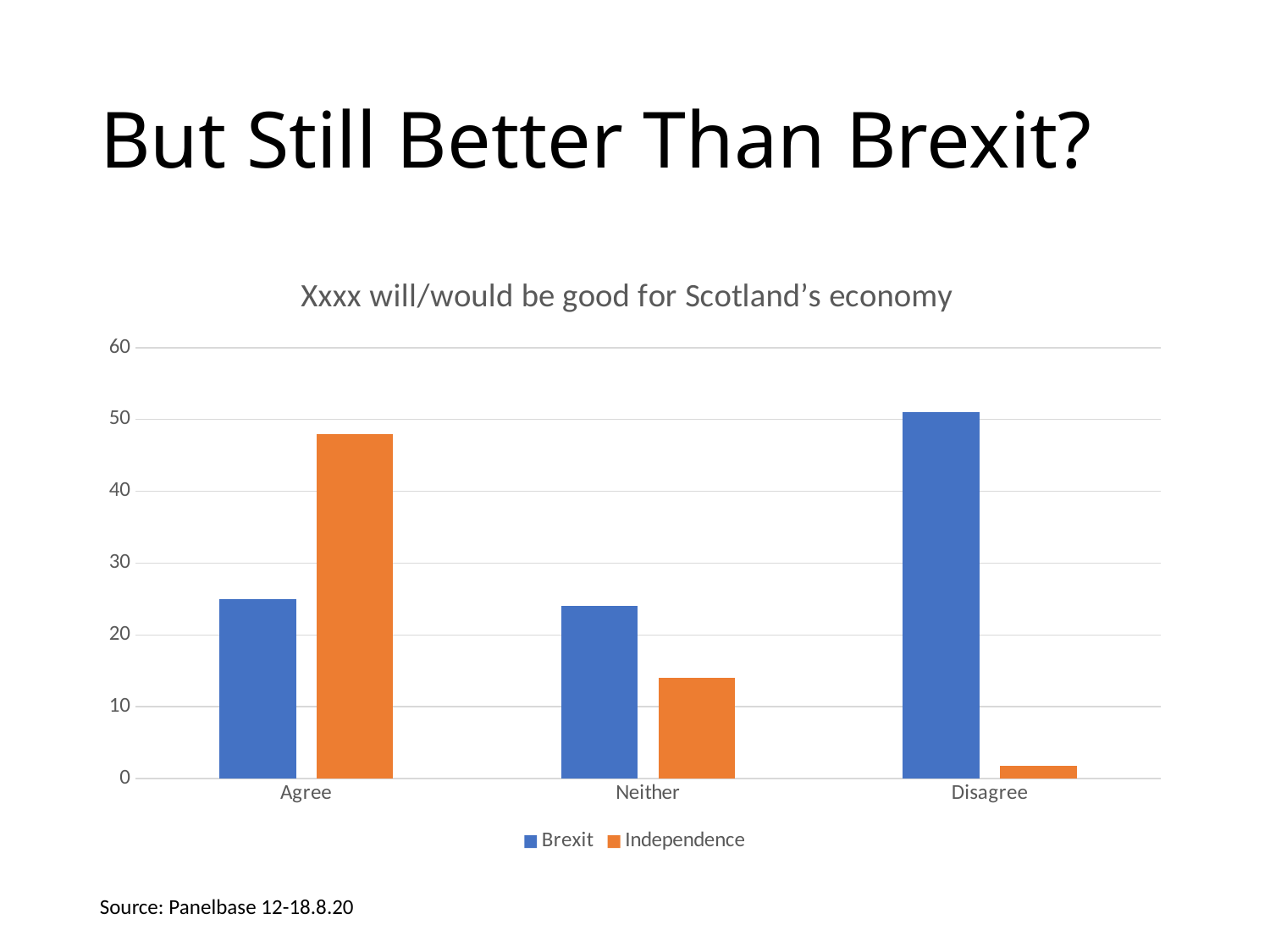
For which category is the Independence bar highest? Agree In the Disagree category, which series has the larger value, Brexit or Independence? Brexit Is the value for Independence in the Agree category greater or less than 40? greater What kind of chart is shown on the slide? bar chart For which category is the Independence bar lowest? Disagree What is the title of the chart? Xxxx will/would be good for Scotland’s economy Which colour represents the Independence series? orange For which category is the Brexit bar highest? Disagree How many categories are shown on the x axis? 3 Is the value for Independence in the Disagree category greater or less than 10? less How many series does the legend list? 2 In the Agree category, which series has the larger value, Brexit or Independence? Independence